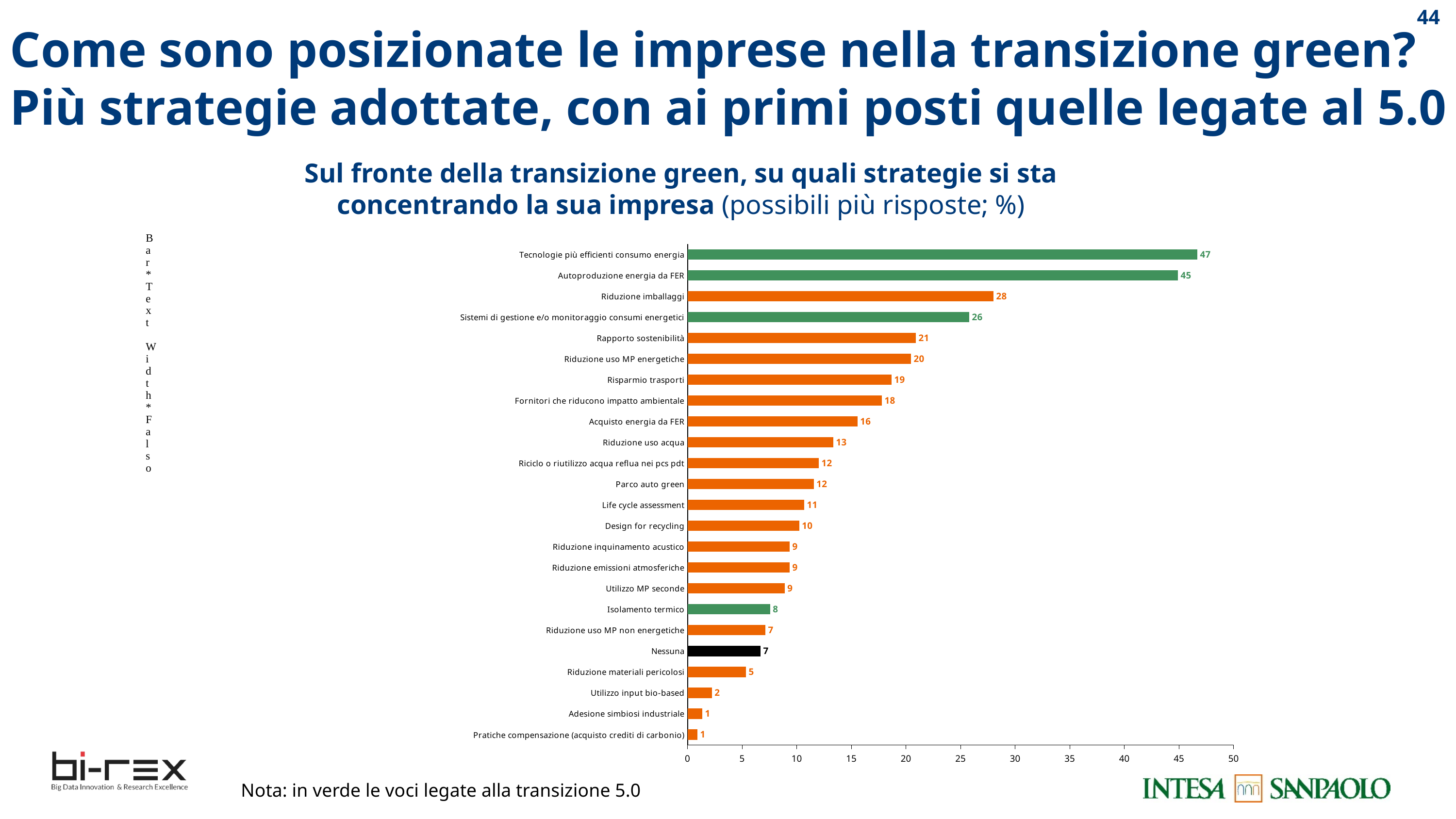
Is the value for Risparmio trasporti greater or less than 15? greater What is the value for Riduzione imballaggi? 28 How many categories are shown in the chart? 24 What is the value for Tecnologie più efficienti consumo energia? 47 What is the value for Nessuna? 7 What is the difference between Rapporto sostenibilità and Acquisto energia da FER? 5 Which is larger, Riduzione imballaggi or Sistemi di gestione e/o monitoraggio consumi energetici? Riduzione imballaggi What kind of chart is shown on the slide? Bar chart What is the value for Isolamento termico? 8 According to the note, what do the green bars represent? Le voci legate alla transizione 5.0 Which category has the highest value? Tecnologie più efficienti consumo energia What is the difference between Tecnologie più efficienti consumo energia and Autoproduzione energia da FER? 2